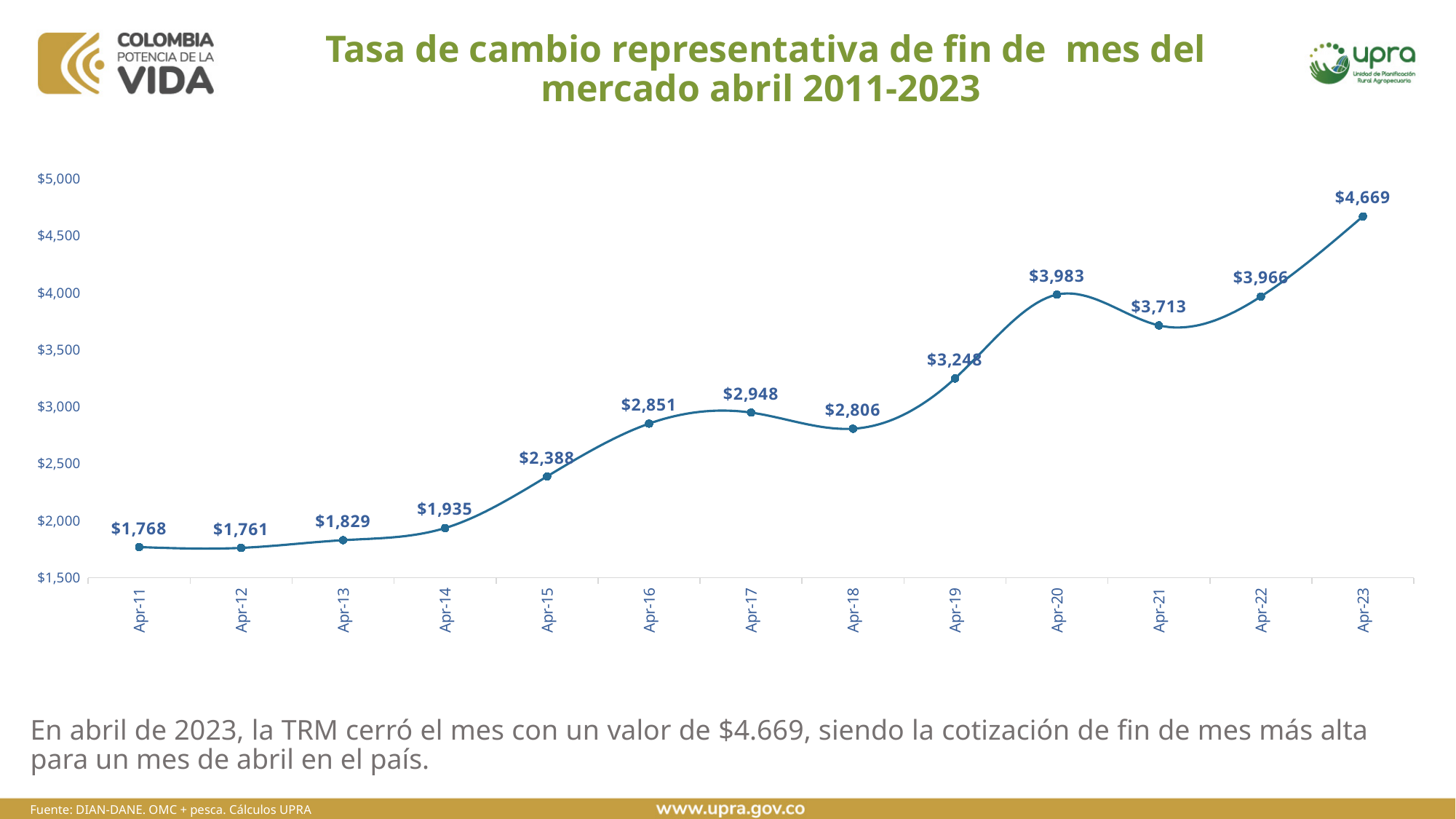
What is the difference between the values for Apr-20 and Apr-21? $270 What is the value for Apr-20? $3,983 Which point has the lowest value? Apr-12 What is the value for Apr-15? $2,388 What kind of chart is shown on the slide? line chart Do the values generally rise or fall from Apr-11 to Apr-23? rise How many data points are plotted on the chart? 13 What is the difference between the values for Apr-23 and Apr-22? $703 Which is larger, the value for Apr-17 or the value for Apr-18? Apr-17 Is the value for Apr-19 greater or less than $3,000? greater What is the value for Apr-23? $4,669 Which point has the highest value? Apr-23